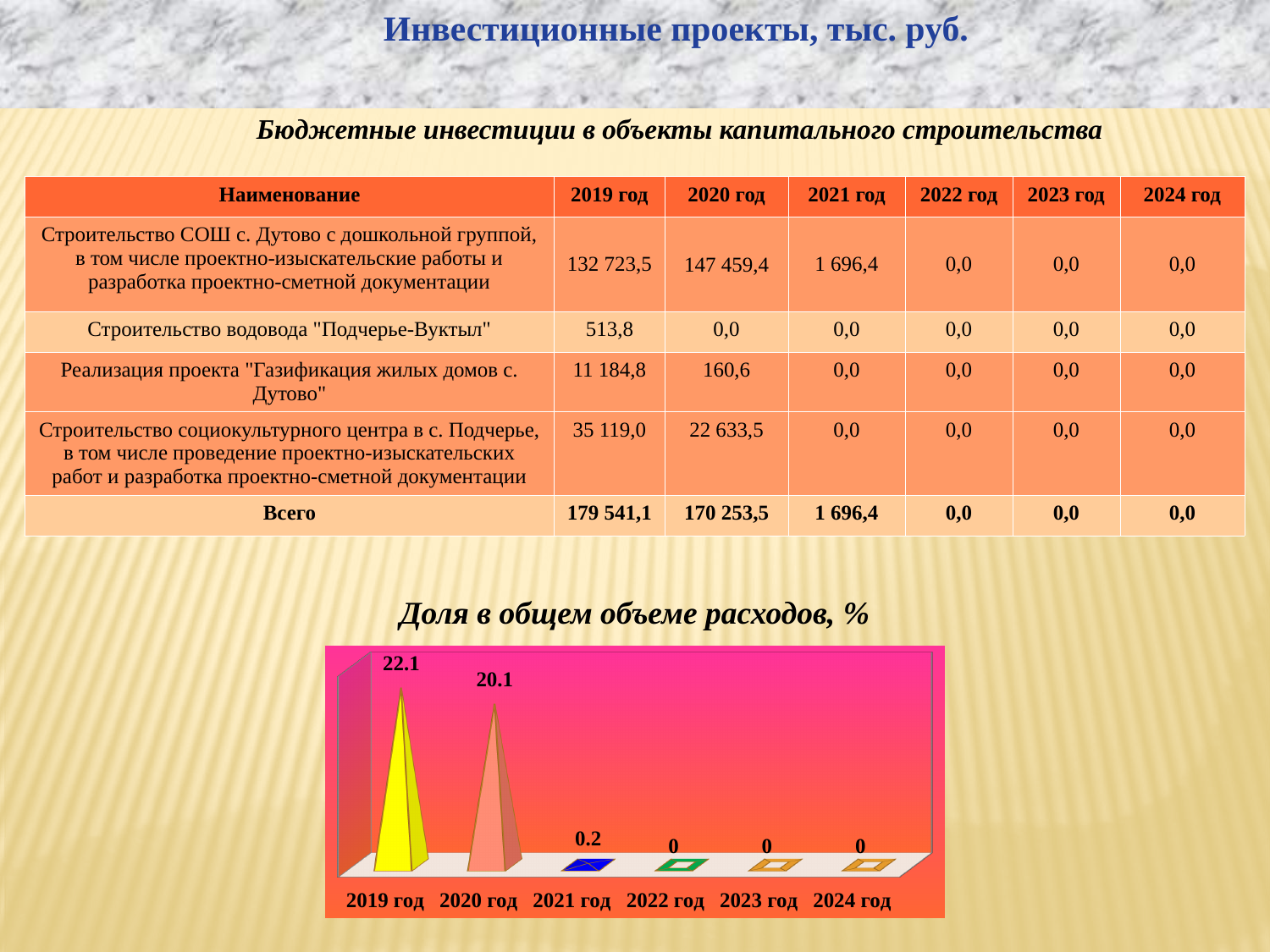
What is the value for 2019 год in the chart? 22.1 What is the difference between the values for 2020 год and 2021 год? 19.9 Do the values rise or fall from 2019 год to 2021 год? fall What is the title of the chart? Доля в общем объеме расходов, % What is the difference between the values for 2019 год and 2020 год? 2 What is the value for 2020 год in the chart? 20.1 Which is larger, the value for 2019 год or the value for 2020 год? 2019 год What is the value for 2021 год in the chart? 0.2 What is the value for 2022 год in the chart? 0 How many years are shown on the x axis of the chart? 6 Which year has the highest value in the chart? 2019 год What kind of chart is shown on the slide? bar chart